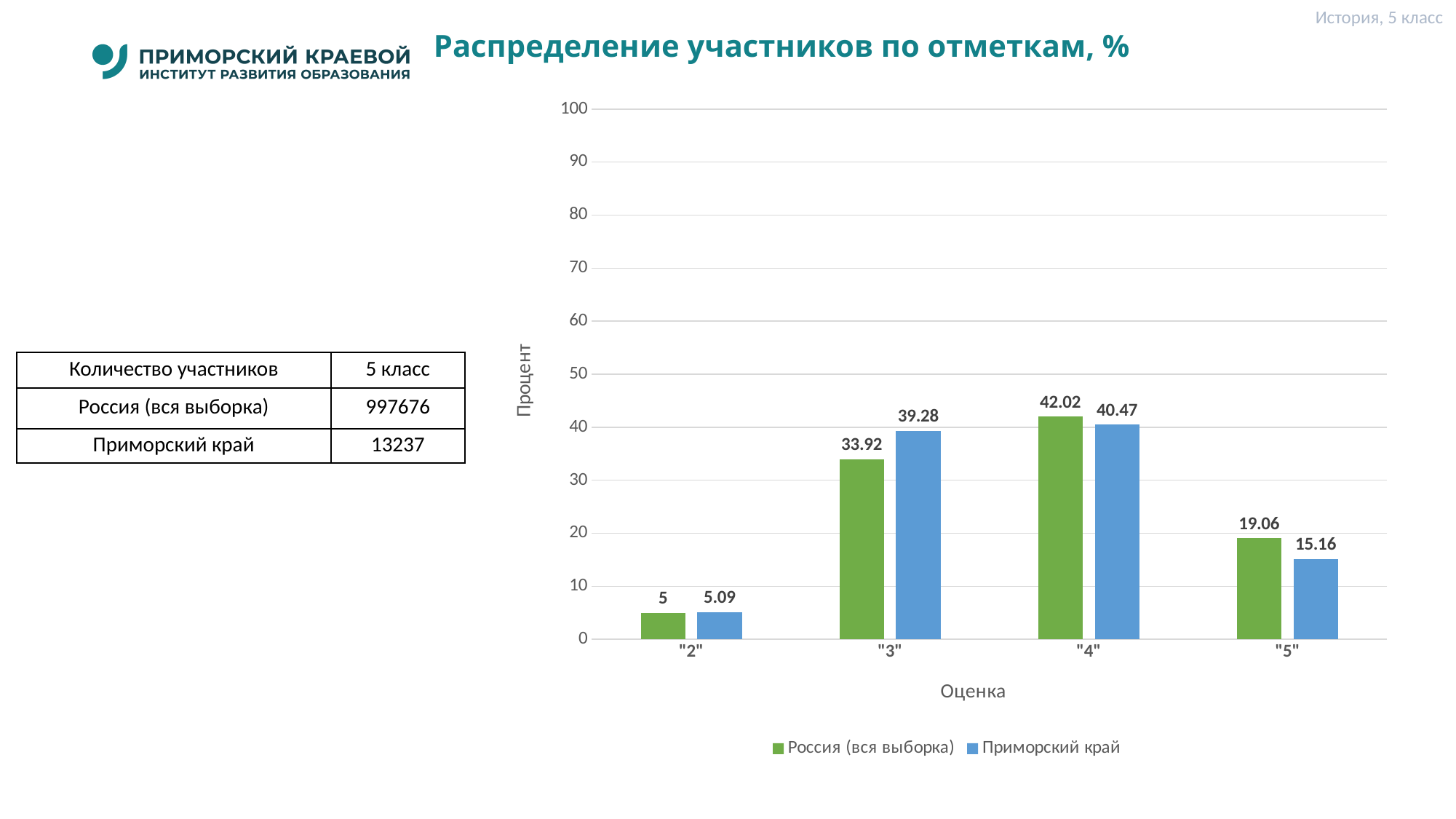
What is the value for Приморский край at grade "2"? 5.09 What is the value for Приморский край at grade "3"? 39.28 What is the title of the chart? Распределение участников по отметкам, % At grade "5", which series has the larger value: Россия (вся выборка) or Приморский край? Россия (вся выборка) Which grade has the lowest value for Приморский край? "2" Which grade has the highest value for Россия (вся выборка)? "4" How many series does the legend list? 2 How many grade categories are shown on the x axis? 4 What is the difference between Приморский край and Россия (вся выборка) at grade "3"? 5.36 What is the value for Россия (вся выборка) at grade "5"? 19.06 Is the value for Приморский край at grade "4" greater or less than 30? greater What kind of chart is shown on the slide? bar chart